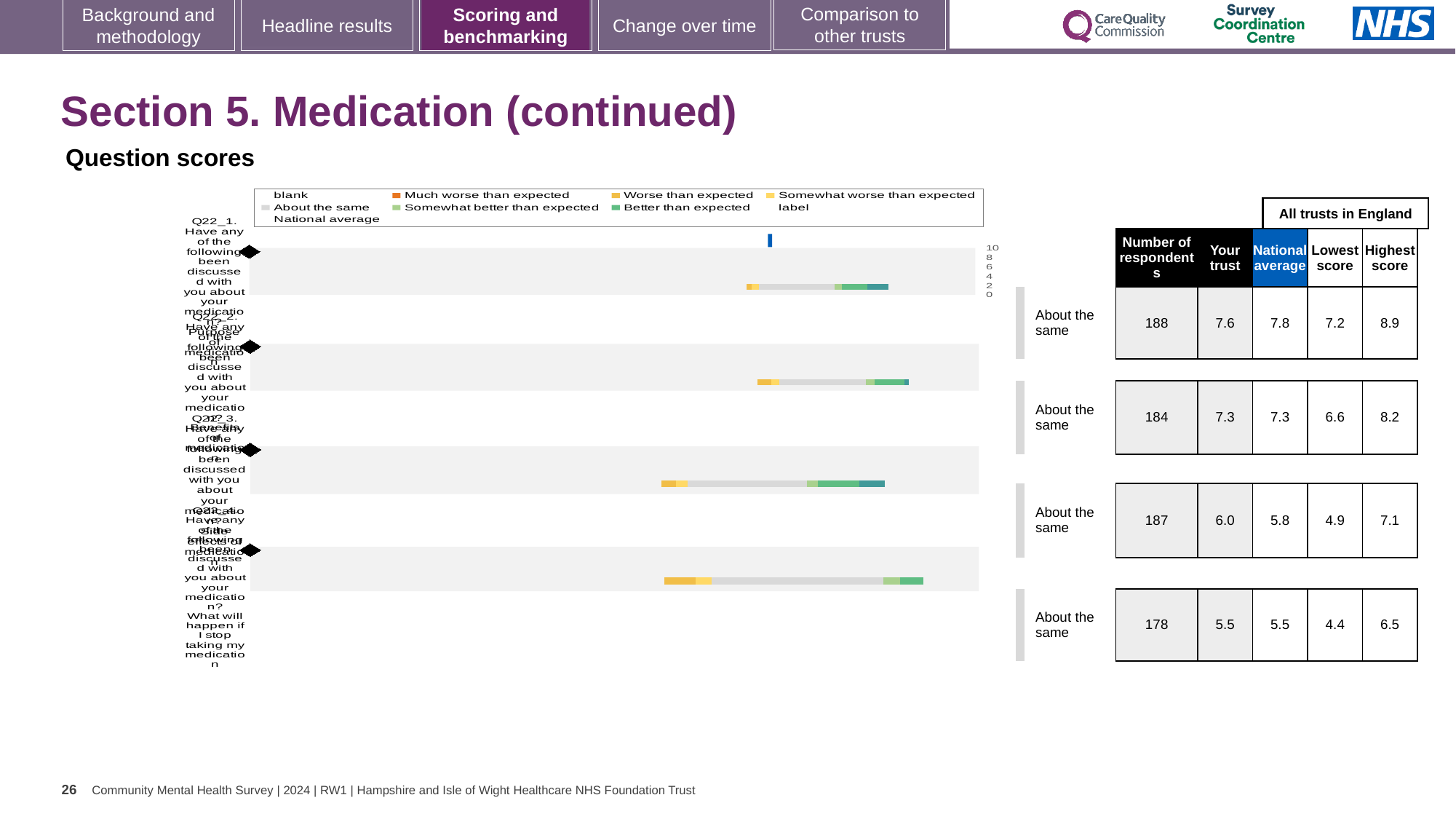
What is the lowest score for the second row (Q22_2)? 6.6 What kind of chart is shown on the slide? bar chart Which row has the lowest 'Highest score' value? Q22_4 (fourth row) What benchmark category is shown next to each of the four rows? About the same What is the 'Your trust' score for the first row (Q22_1)? 7.6 For the first row (Q22_1), what is the difference between the highest score and the lowest score? 1.7 For the third row (Q22_3), what is the difference between the 'Your trust' score and the national average? 0.2 How many question rows (bars) does the chart show? 4 For the first row (Q22_1), which is larger: the 'Your trust' score or the national average? National average Which row has the highest 'Your trust' score? Q22_1 (first row) What is the number of respondents for the fourth row (Q22_4)? 178 What is the national average for the third row (Q22_3)? 5.8